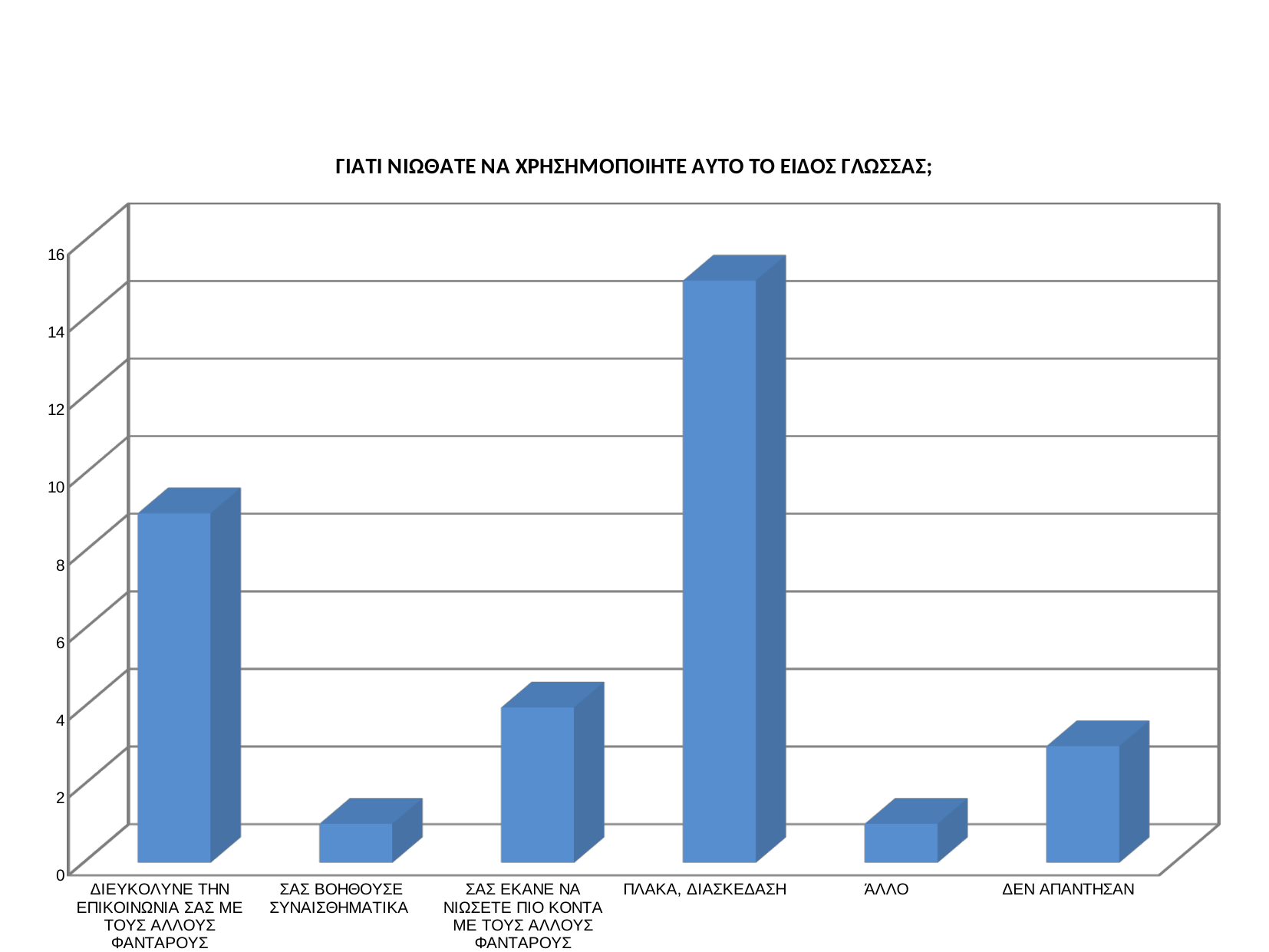
How many categories are shown on the x axis of the chart? 6 Is the value for ΔΙΕΥΚΟΛΥΝΕ ΤΗΝ ΕΠΙΚΟΙΝΩΝΙΑ ΣΑΣ ΜΕ ΤΟΥΣ ΑΛΛΟΥΣ ΦΑΝΤΑΡΟΥΣ greater or less than 10? less Is the value for ΔΕΝ ΑΠΑΝΤΗΣΑΝ greater or less than 4? less Is the value for ΣΑΣ ΕΚΑΝΕ ΝΑ ΝΙΩΣΕΤΕ ΠΙΟ ΚΟΝΤΑ ΜΕ ΤΟΥΣ ΑΛΛΟΥΣ ΦΑΝΤΑΡΟΥΣ greater or less than 6? less What type of chart is shown on the slide? Bar chart Which category has the highest bar? ΠΛΑΚΑ, ΔΙΑΣΚΕΔΑΣΗ What is the title of the chart? ΓΙΑΤΙ ΝΙΩΘΑΤΕ ΝΑ ΧΡΗΣΗΜΟΠΟΙΗΤΕ ΑΥΤΟ ΤΟ ΕΙΔΟΣ ΓΛΩΣΣΑΣ; Which is larger: the value for ΔΕΝ ΑΠΑΝΤΗΣΑΝ or the value for ΆΛΛΟ? ΔΕΝ ΑΠΑΝΤΗΣΑΝ Which is larger: the value for ΔΙΕΥΚΟΛΥΝΕ ΤΗΝ ΕΠΙΚΟΙΝΩΝΙΑ ΣΑΣ ΜΕ ΤΟΥΣ ΑΛΛΟΥΣ ΦΑΝΤΑΡΟΥΣ or the value for ΣΑΣ ΕΚΑΝΕ ΝΑ ΝΙΩΣΕΤΕ ΠΙΟ ΚΟΝΤΑ ΜΕ ΤΟΥΣ ΑΛΛΟΥΣ ΦΑΝΤΑΡΟΥΣ? ΔΙΕΥΚΟΛΥΝΕ ΤΗΝ ΕΠΙΚΟΙΝΩΝΙΑ ΣΑΣ ΜΕ ΤΟΥΣ ΑΛΛΟΥΣ ΦΑΝΤΑΡΟΥΣ